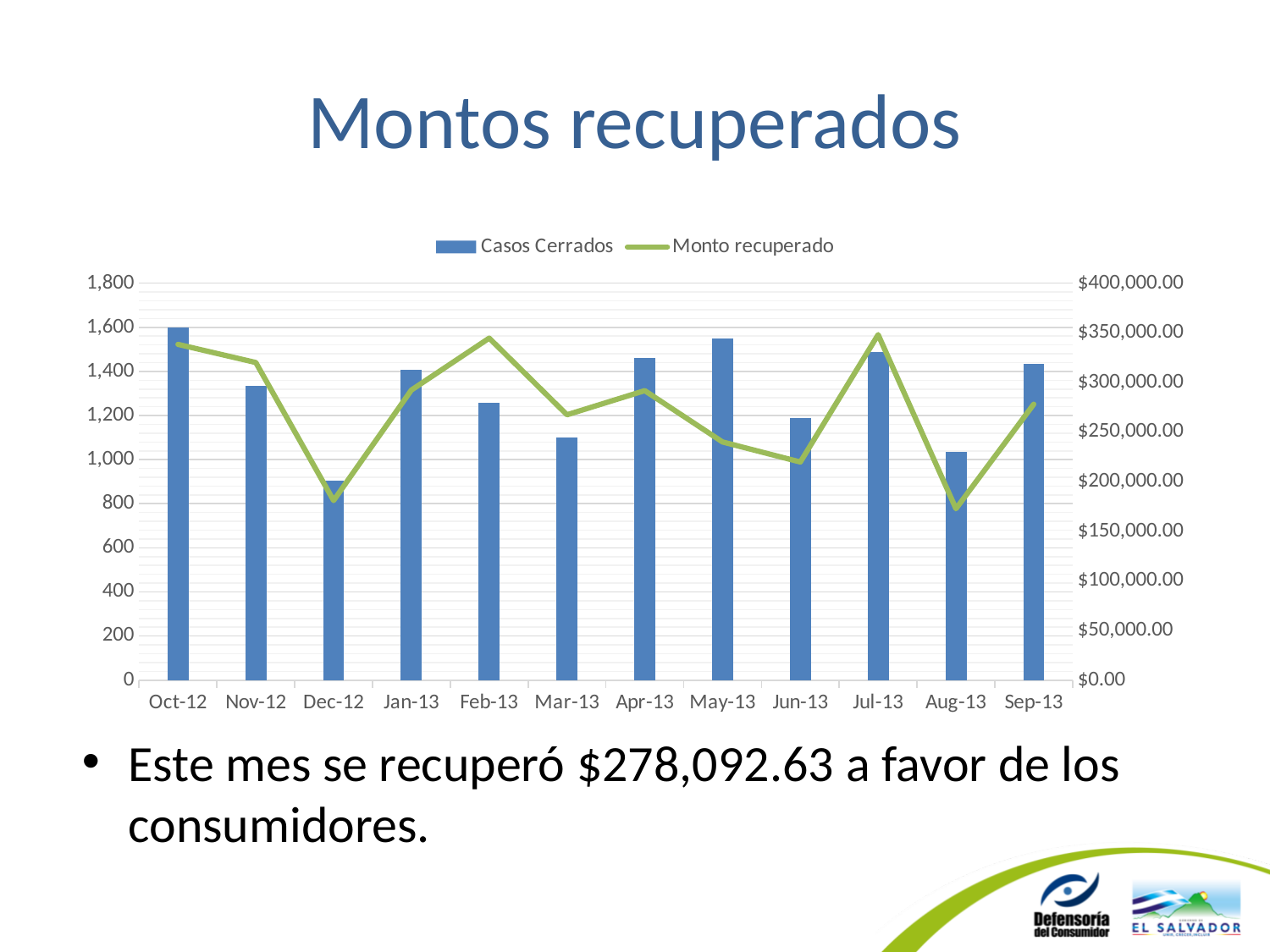
What is the highest tick shown on the right-hand axis? $400,000.00 Which has the larger Casos Cerrados value, Jan-13 or Mar-13? Jan-13 Is the Monto recuperado value for Aug-13 greater or less than $200,000.00? less How many series does the legend list? 2 What colour is the Monto recuperado line? Green Which month has the lowest Casos Cerrados bar? Dec-12 Which month has the highest Casos Cerrados bar? Oct-12 Is the Casos Cerrados value for May-13 greater or less than 1,400? greater How many months are shown on the x axis? 12 Is the Monto recuperado value for Feb-13 greater or less than $300,000.00? greater What kind of chart is shown on the slide? A combination bar and line chart